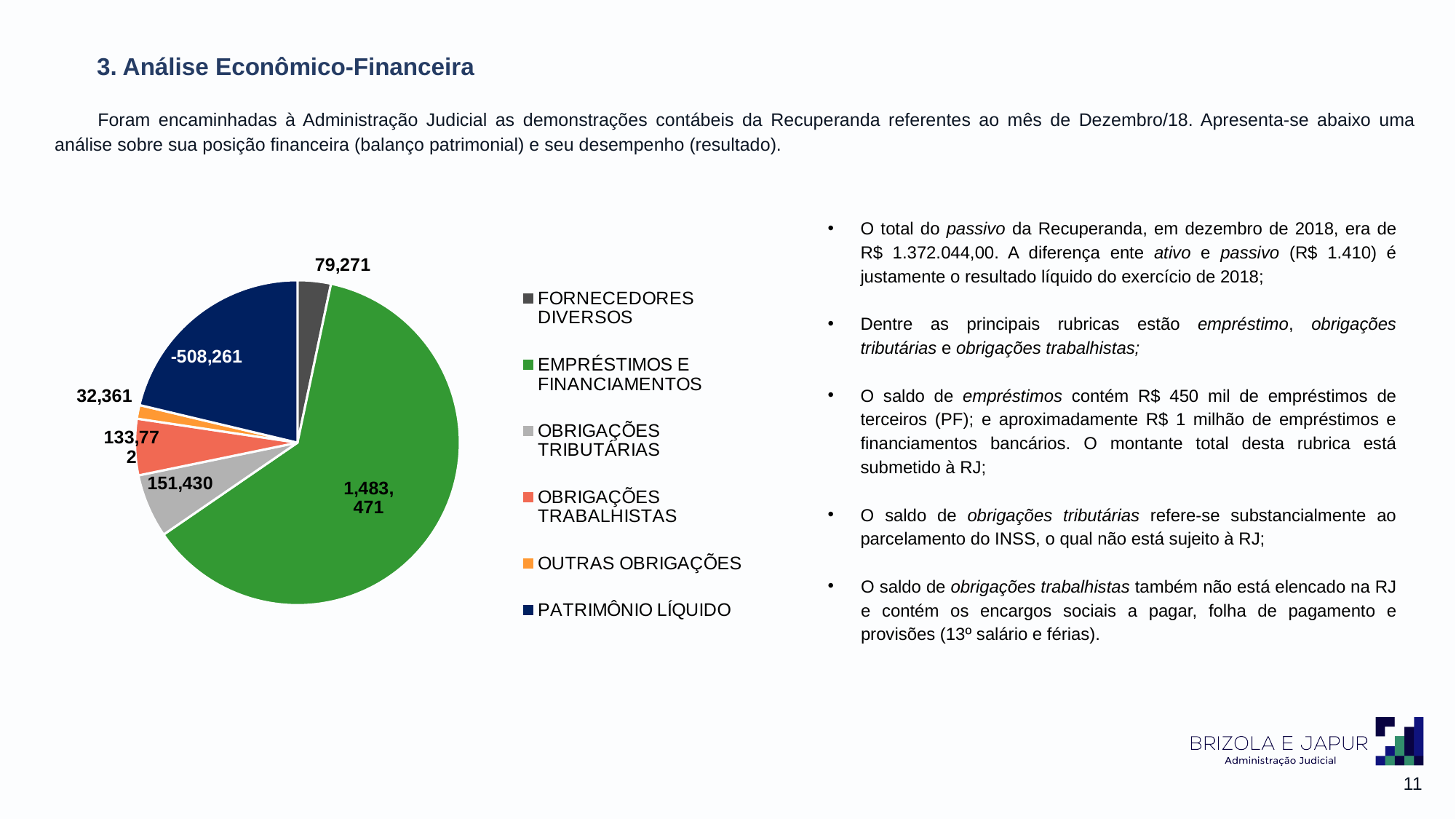
What is the value shown for PATRIMÔNIO LÍQUIDO? -508,261 What type of chart is shown on the slide? Pie chart Which category has the largest slice of the pie? EMPRÉSTIMOS E FINANCIAMENTOS Which category has the smallest slice of the pie? OUTRAS OBRIGAÇÕES What colour is the slice for EMPRÉSTIMOS E FINANCIAMENTOS? Green What is the value shown for OUTRAS OBRIGAÇÕES? 32,361 What is the difference between the values for OBRIGAÇÕES TRIBUTÁRIAS and OBRIGAÇÕES TRABALHISTAS? 17,658 What is the value shown for EMPRÉSTIMOS E FINANCIAMENTOS? 1,483,471 What is the value shown for OBRIGAÇÕES TRIBUTÁRIAS? 151,430 Which is larger, the value for FORNECEDORES DIVERSOS or the value for OUTRAS OBRIGAÇÕES? FORNECEDORES DIVERSOS How many categories does the pie chart show? 6 What is the value shown for FORNECEDORES DIVERSOS? 79,271